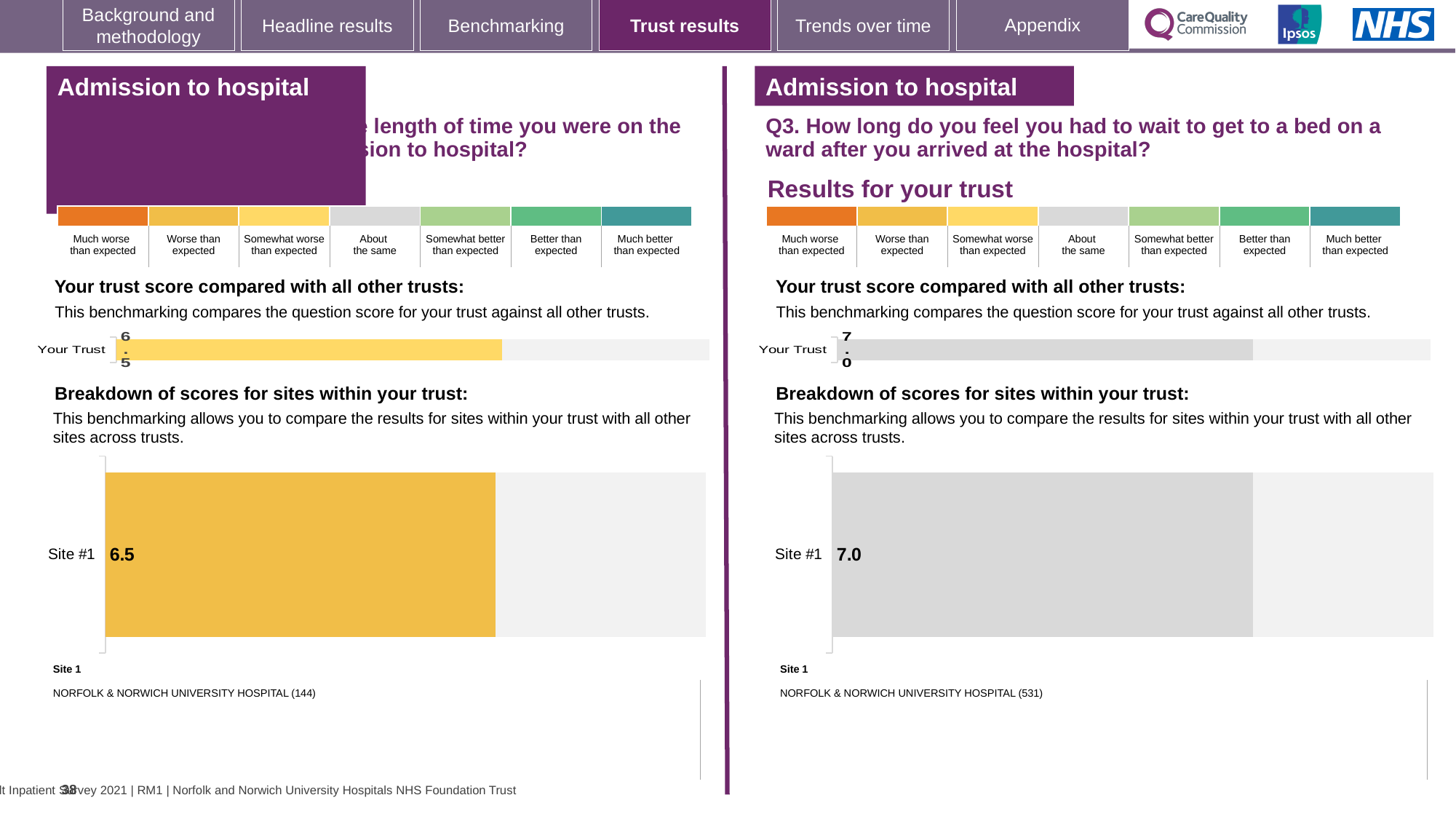
How many sites are shown in the right-hand 'Breakdown of scores for sites within your trust' chart? 1 In the left-hand 'Breakdown of scores for sites within your trust' chart, what is the score for Site #1? 6.5 What type of chart is used to show the Site #1 score on the right half of the slide? Bar chart What type of chart is used to show the Your Trust score on the left half of the slide? Bar chart In the right-hand 'Breakdown of scores for sites within your trust' chart (Q3), what is the score for Site #1? 7.0 Which is larger: the Site #1 score in the left-hand breakdown chart or the Site #1 score in the right-hand breakdown chart? The right-hand chart (7.0) How many sites are shown in the left-hand 'Breakdown of scores for sites within your trust' chart? 1 What is the difference between the Site #1 score in the right-hand breakdown chart (7.0) and the Site #1 score in the left-hand breakdown chart (6.5)? 0.5 On the left half of the slide, what is the score shown for Your Trust in the 'Your trust score compared with all other trusts' bar chart? 6.5 What colour is the Site #1 bar in the left-hand breakdown chart? Yellow/gold Which site name is listed as Site 1 beneath the right-hand breakdown chart? NORFOLK & NORWICH UNIVERSITY HOSPITAL (531) On the right half of the slide (Q3), what is the score shown for Your Trust in the 'Your trust score compared with all other trusts' bar chart? 7.0